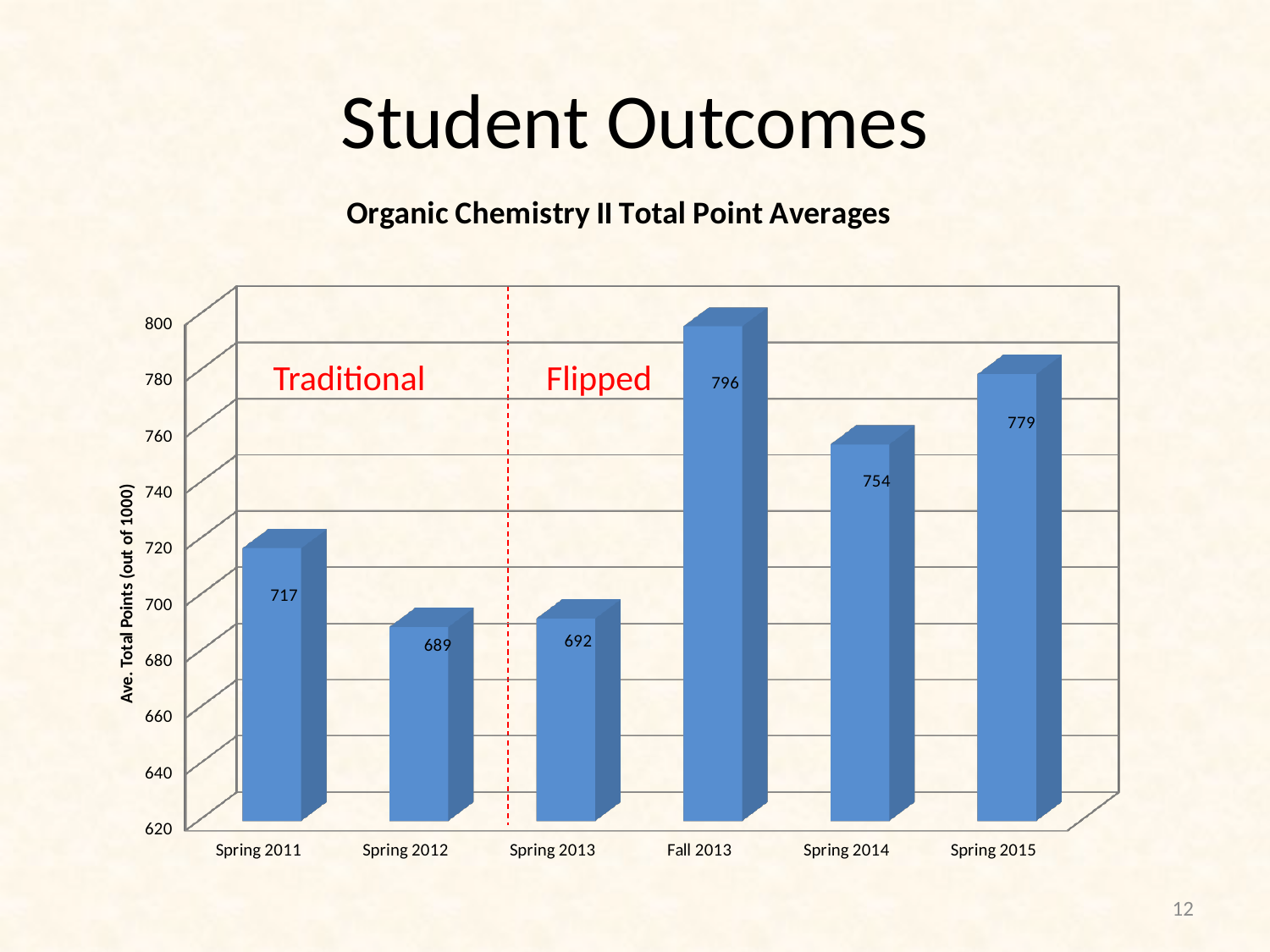
Is the value for Spring 2014 greater or less than 740? greater What is the average total points value for Fall 2013? 796 What is the difference in average total points between Fall 2013 and Spring 2013? 104 Which semester has the highest average total points? Fall 2013 What is the difference in average total points between Spring 2011 and Spring 2012? 28 What is the average total points value for Spring 2015? 779 What is the average total points value for Spring 2012? 689 What is the title of the chart? Organic Chemistry II Total Point Averages Which has a higher average total points, Spring 2014 or Spring 2015? Spring 2015 What kind of chart is shown on the slide? bar chart How many semesters are shown on the chart? 6 Which semester has the lowest average total points? Spring 2012